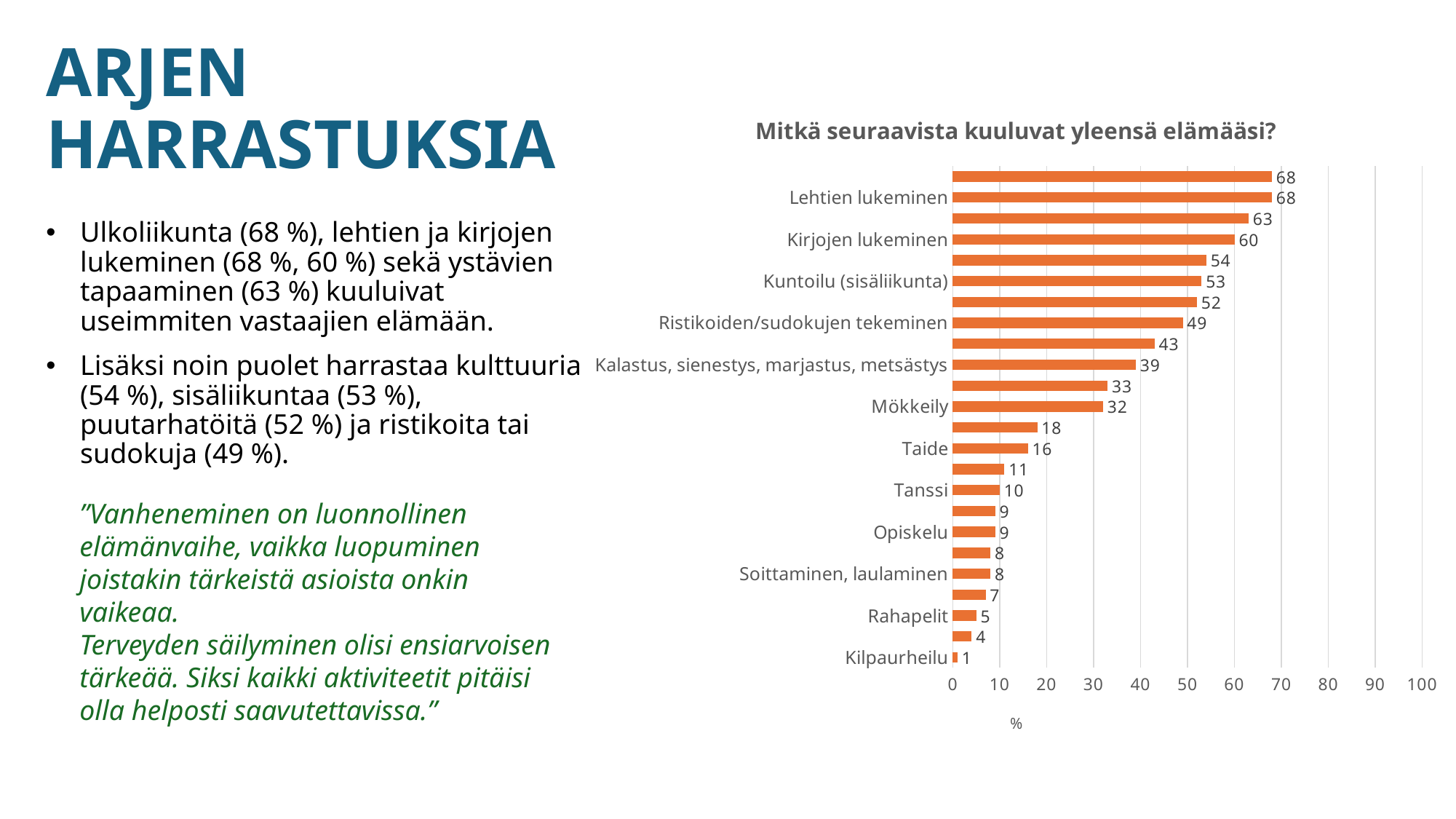
How many bars are plotted in the chart? 24 What is the value for Rahapelit? 5 What is the value for Kirjojen lukeminen? 60 Which labelled category has the lowest value? Kilpaurheilu What is the value for Mökkeily? 32 Which has a larger value, Taide or Tanssi? Taide What type of chart is shown on the slide? bar chart What is the value for Lehtien lukeminen? 68 Is the value for Ristikoiden/sudokujen tekeminen greater or less than 40? greater What is the difference between the values for Lehtien lukeminen and Kirjojen lukeminen? 8 What is the value for Kuntoilu (sisäliikunta)? 53 What is the title of the chart? Mitkä seuraavista kuuluvat yleensä elämääsi?